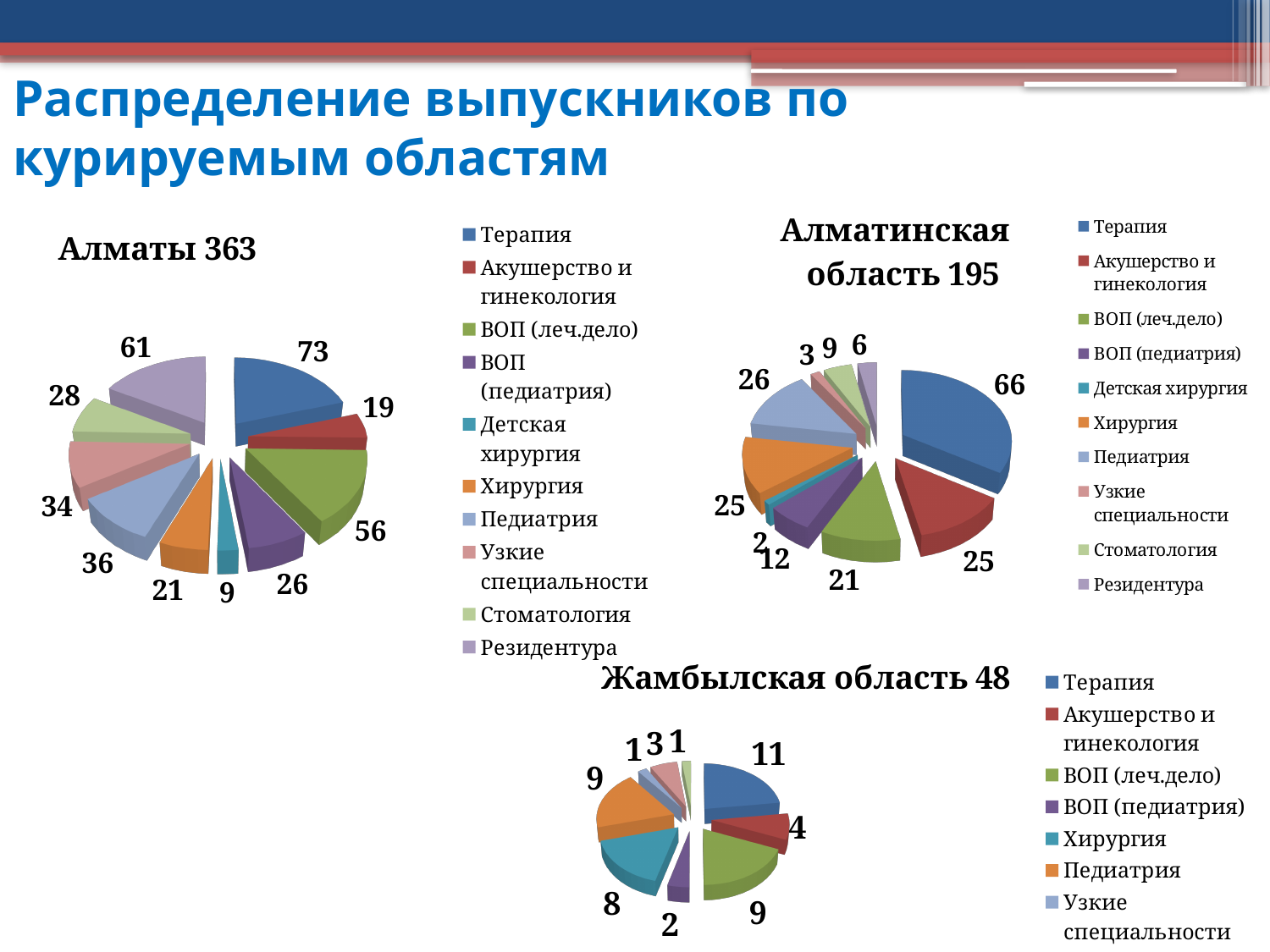
In the chart titled "Жамбылская область 48", what is the value for Хирургия? 8 In the chart titled "Алматы 363", how many slices does the pie have? 10 In the chart titled "Алматы 363", what is the difference between Резидентура and Стоматология? 33 In the chart titled "Алматы 363", which category has the smallest slice? Детская хирургия In the chart titled "Алматинская область 195", which category has the largest slice? Терапия In the chart titled "Жамбылская область 48", what share of the total does Терапия represent, given the total of 48 in the title? 22.9% In the chart titled "Алматинская область 195", what is the value for Педиатрия? 26 In the chart titled "Алматинская область 195", which is larger: ВОП (леч.дело) or ВОП (педиатрия)? ВОП (леч.дело) In the chart titled "Алматинская область 195", what is the value for Детская хирургия? 2 What type of chart is used for "Алматы 363"? Pie chart In the chart titled "Жамбылская область 48", which category has the largest slice? Терапия In the chart titled "Алматы 363", what is the value for Терапия? 73